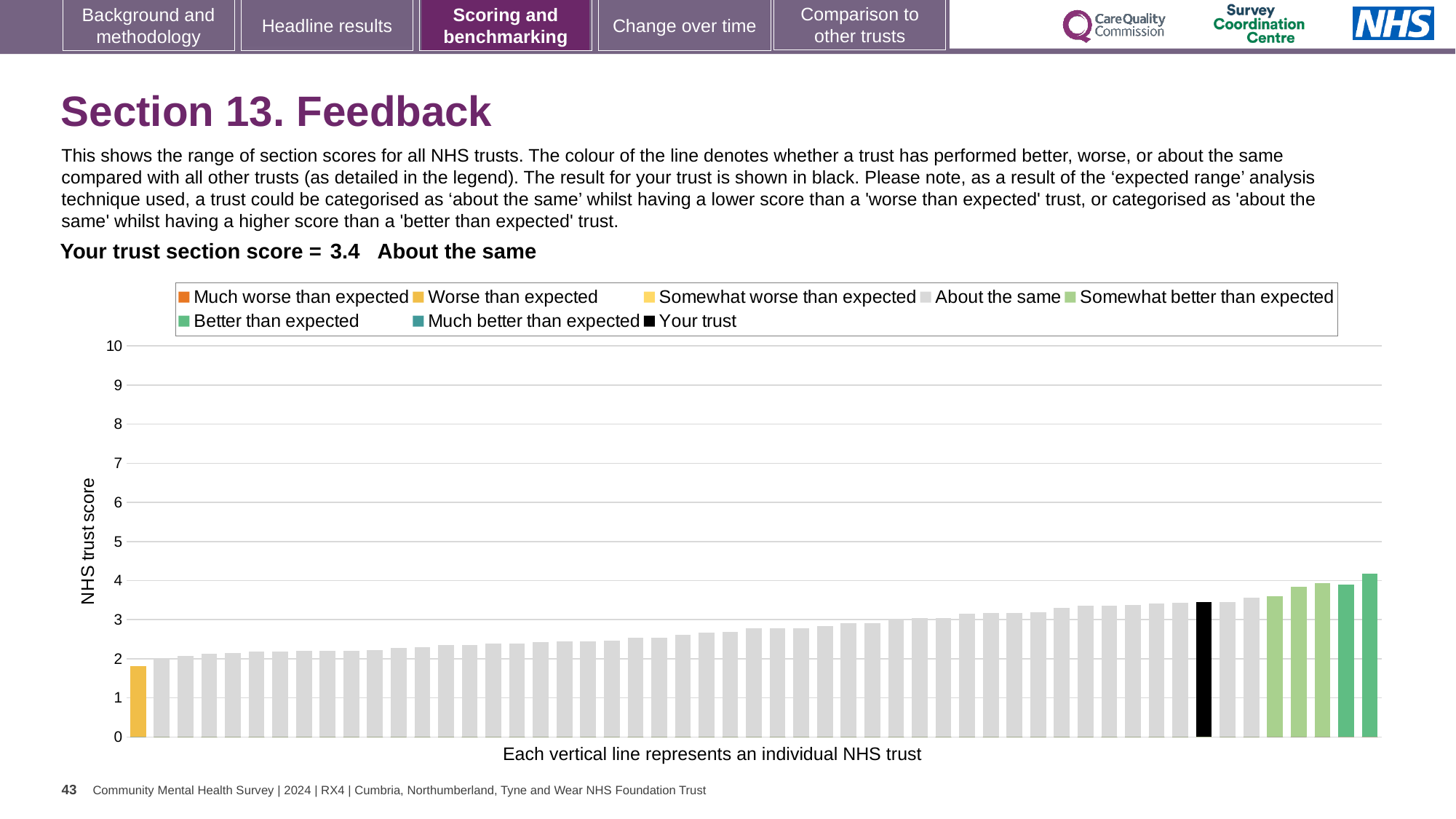
Do the bar values rise or fall from left to right along the x axis? rise What kind of chart is shown on the slide? bar chart Is the value of the highest bar greater or less than 4? greater What is the section score for your trust? 3.4 Which legend category does the highest bar belong to? Better than expected What is the label on the y axis? NHS trust score Which legend category does the lowest bar belong to? Worse than expected Is the value of the lowest bar greater or less than 3? less Is the value for your trust greater or less than 3? greater How many entries does the chart legend list? 8 What colour is the bar representing your trust? black